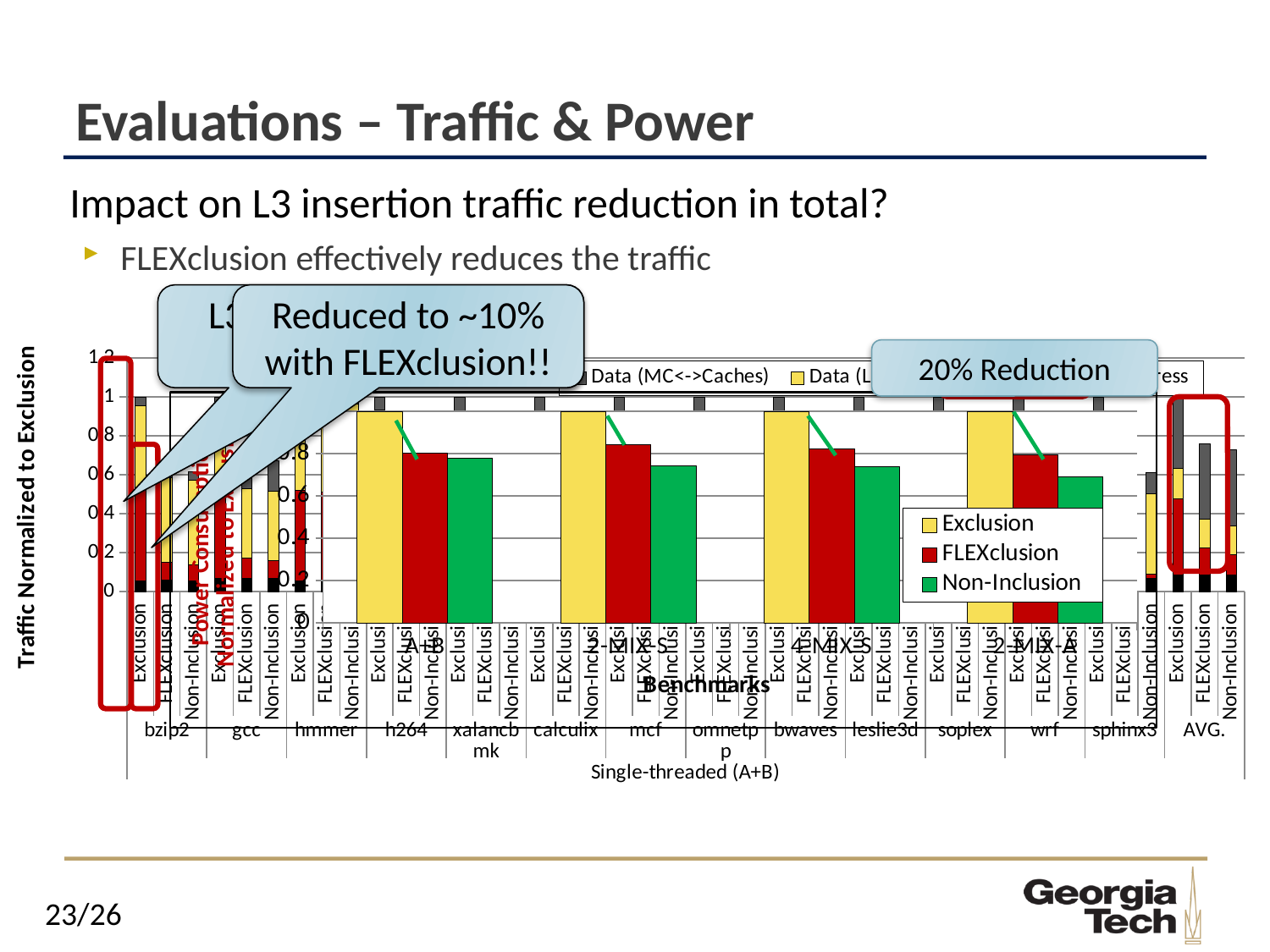
In the background chart 'Traffic Normalized to Exclusion', how many benchmark groups (including AVG.) are shown on the x axis? 14 In the foreground chart 'Power Consumption Normalized to Exclusion', which is larger for 2-MIX-S: the FLEXclusion value or the Non-Inclusion value? FLEXclusion In the foreground chart 'Power Consumption Normalized to Exclusion', which series has the highest bar for 4-MIX-S? Exclusion What kind of chart is the foreground chart titled 'Power Consumption Normalized to Exclusion'? bar chart In the background chart 'Traffic Normalized to Exclusion', what is the x-axis title? Benchmarks In the foreground chart 'Power Consumption Normalized to Exclusion', what are the three legend entries? Exclusion, FLEXclusion, Non-Inclusion In the background chart 'Traffic Normalized to Exclusion', is the FLEXclusion bar for AVG. greater or less than 1? less In the foreground chart 'Power Consumption Normalized to Exclusion', is the FLEXclusion value for A+B greater or less than 0.6? greater In the foreground chart 'Power Consumption Normalized to Exclusion', how many series does the legend list? 3 In the foreground chart 'Power Consumption Normalized to Exclusion', is the Non-Inclusion value for 2-MIX-A greater or less than 0.8? less In the foreground chart 'Power Consumption Normalized to Exclusion', how many workload categories are shown on the x axis? 4 In the background chart 'Traffic Normalized to Exclusion', which is larger for AVG.: the Exclusion bar or the FLEXclusion bar? Exclusion